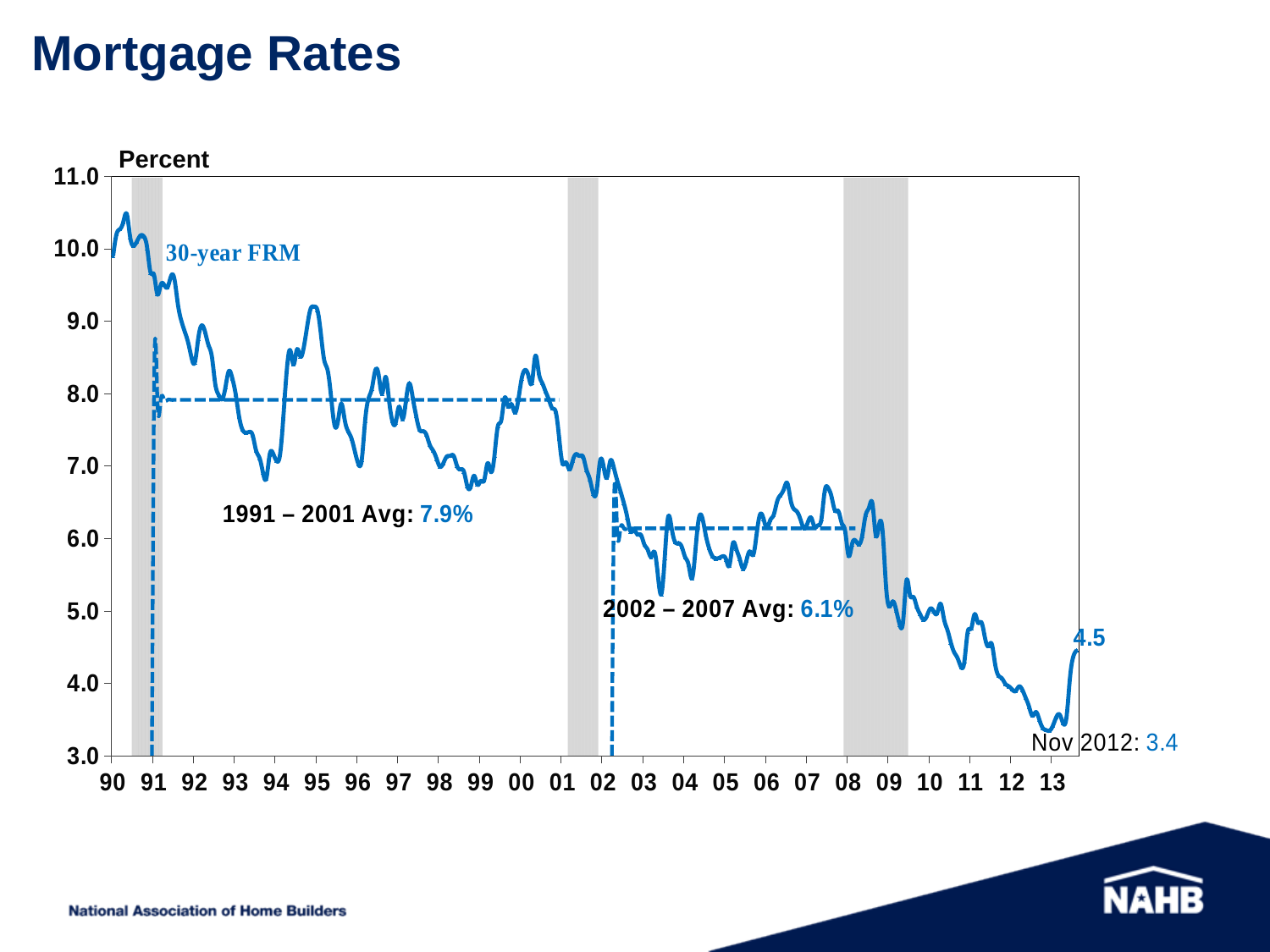
What was the 30-year FRM rate in Nov 2012? 3.4 Is the 30-year FRM rate in 2011 greater or less than 6.0? less What type of chart is shown on the slide? line chart What was the average 30-year FRM rate for 1991 – 2001? 7.9% What is the difference between the 1991 – 2001 average and the 2002 – 2007 average? 1.8% Which period had the higher average rate, 1991 – 2001 or 2002 – 2007? 1991 – 2001 Is the 30-year FRM rate in 1990 greater or less than 9.0? greater What is the title of the chart? Mortgage Rates What series is plotted on the chart? 30-year FRM Overall, does the 30-year FRM rate rise or fall from 1990 to 2013? fall What was the average 30-year FRM rate for 2002 – 2007? 6.1% What is the most recent value labeled at the end of the 30-year FRM line? 4.5